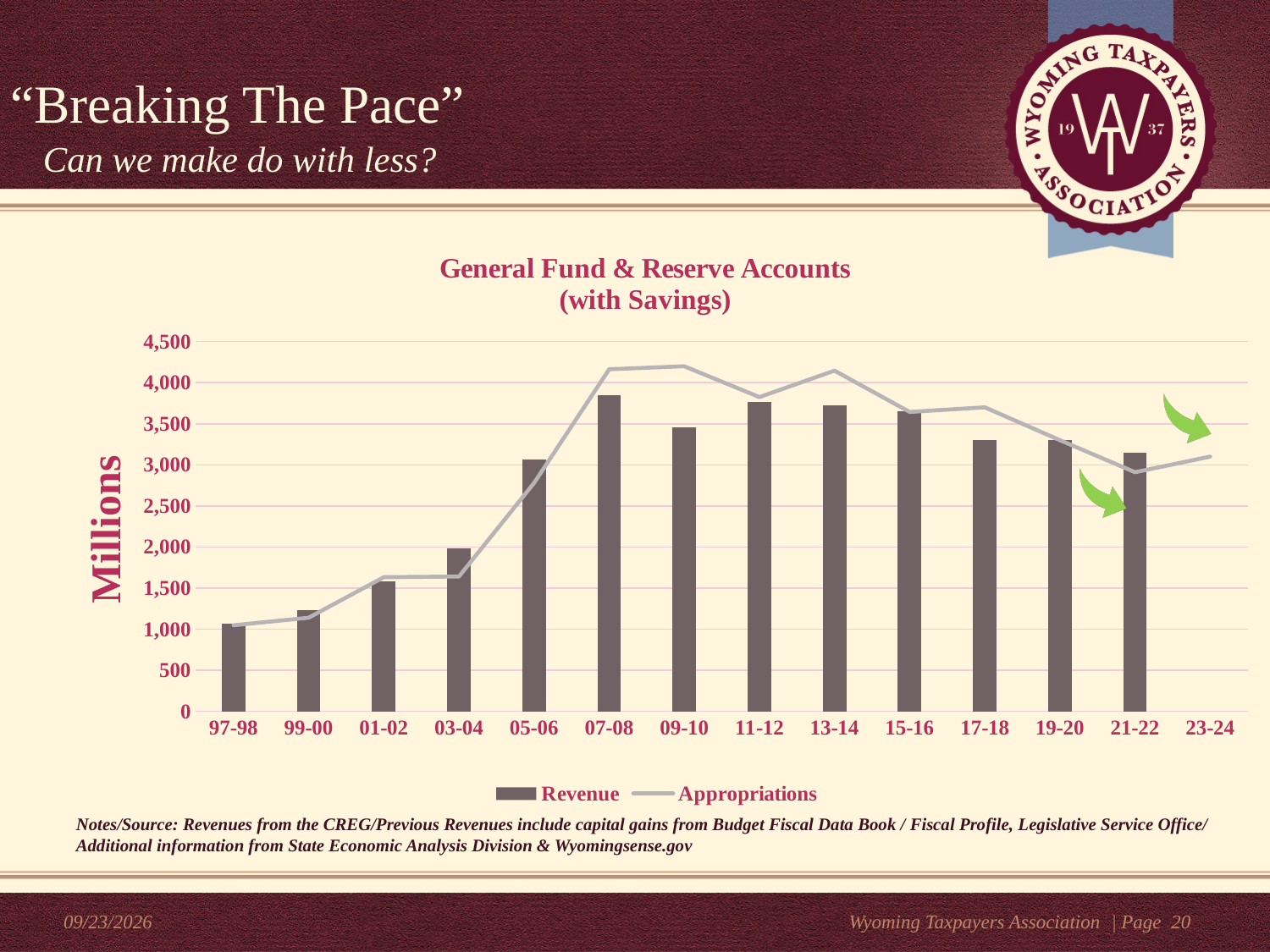
How many series does the legend list? 2 How many categories are shown on the x axis? 14 Is the Revenue value for 03-04 greater or less than 1,500? greater Do the Revenue bars rise or fall from 97-98 to 07-08? rise What is the label on the vertical axis? Millions Is the Appropriations value for 09-10 greater or less than 4,000? greater Is the Revenue value for 17-18 greater or less than 3,000? greater What kind of chart is shown on the slide? A combined bar and line chart Which is larger: the Revenue for 97-98 or the Revenue for 07-08? 07-08 For 07-08, which is larger: Revenue or Appropriations? Appropriations Which category has the lowest Revenue bar? 97-98